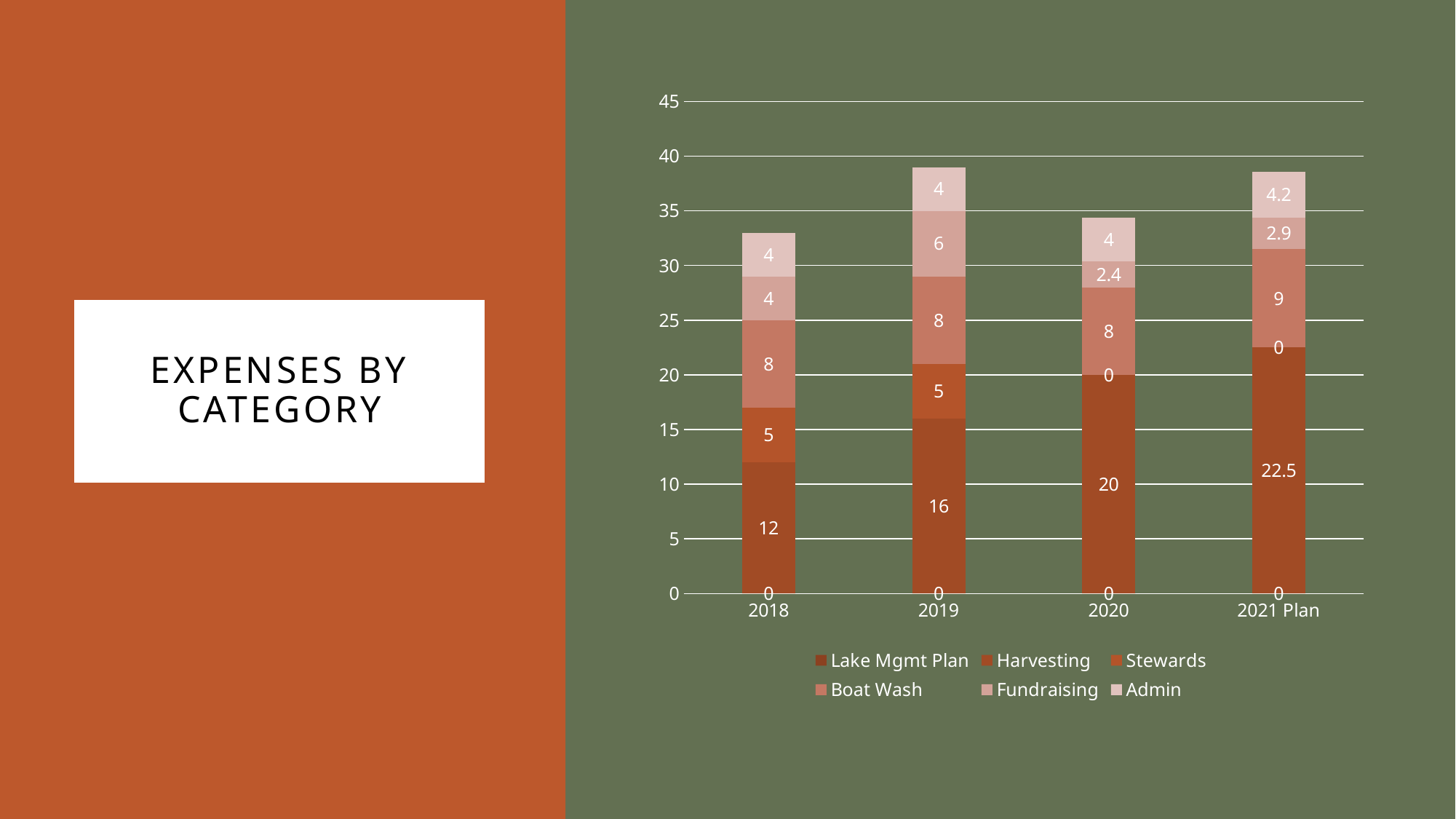
What is the Harvesting value for 2020? 20 Is the Admin value larger for 2021 Plan or for 2020? 2021 Plan How many categories are shown on the x axis? 4 Which category has the lowest Fundraising value? 2020 What type of chart is shown on the slide? Stacked bar chart What is the Boat Wash value for 2019? 8 How many series does the legend list? 6 What is the Fundraising value for 2021 Plan? 2.9 What is the total of the stacked bar for 2018? 33 Does the Harvesting value rise or fall from 2018 to 2021 Plan? Rise What is the difference between the Harvesting values for 2019 and 2018? 4 Which year has the highest Harvesting value? 2021 Plan